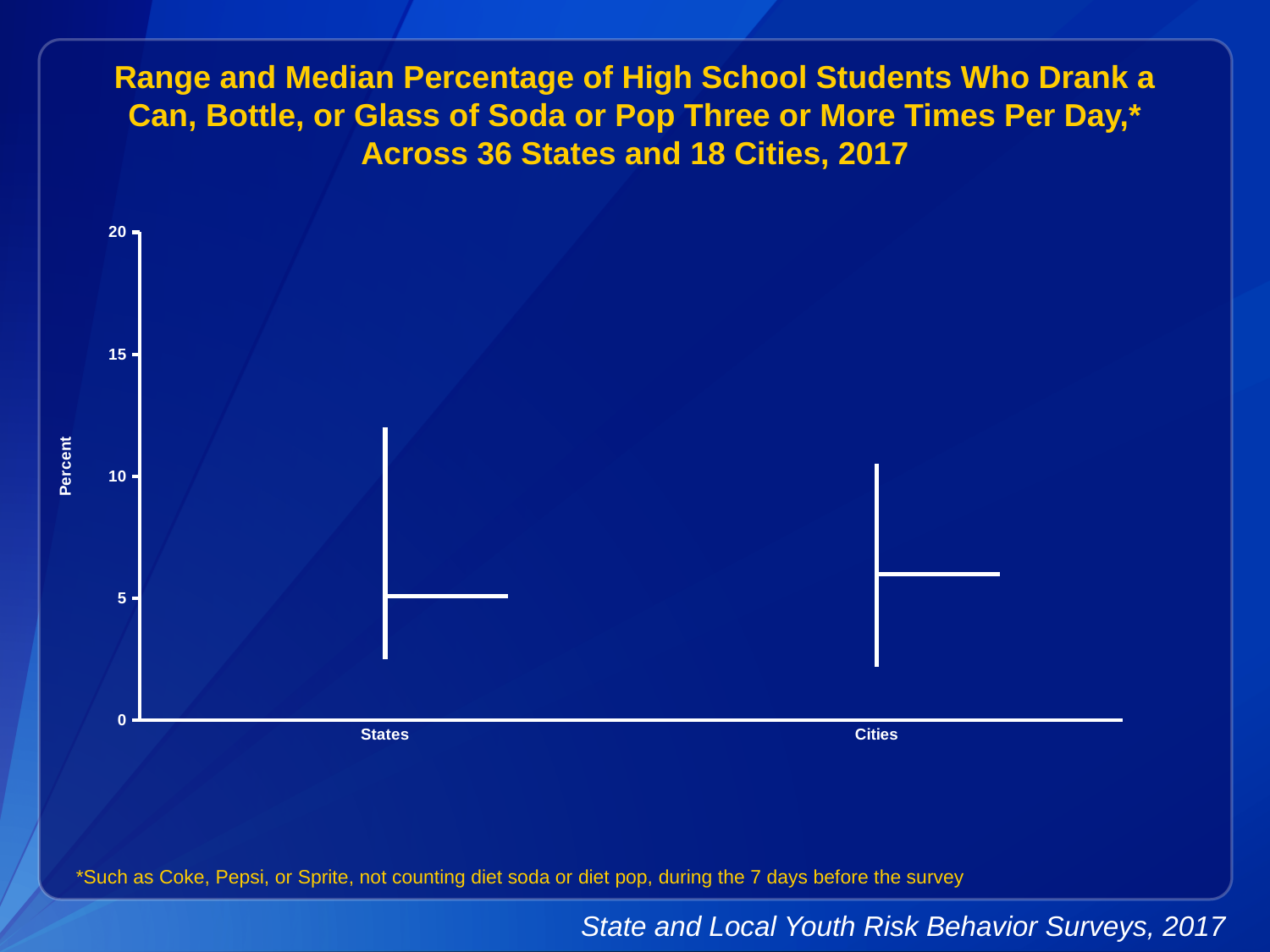
Which category has the higher median value, States or Cities? Cities Is the top of the range for States greater or less than 15? less Is the bottom of the range for Cities greater or less than 5? less Is the median value for Cities greater or less than 10? less How many categories are shown on the x axis of the chart? 2 What is the label of the y axis? Percent Which category has the higher top of its range, States or Cities? States What are the two categories shown on the x axis? States and Cities